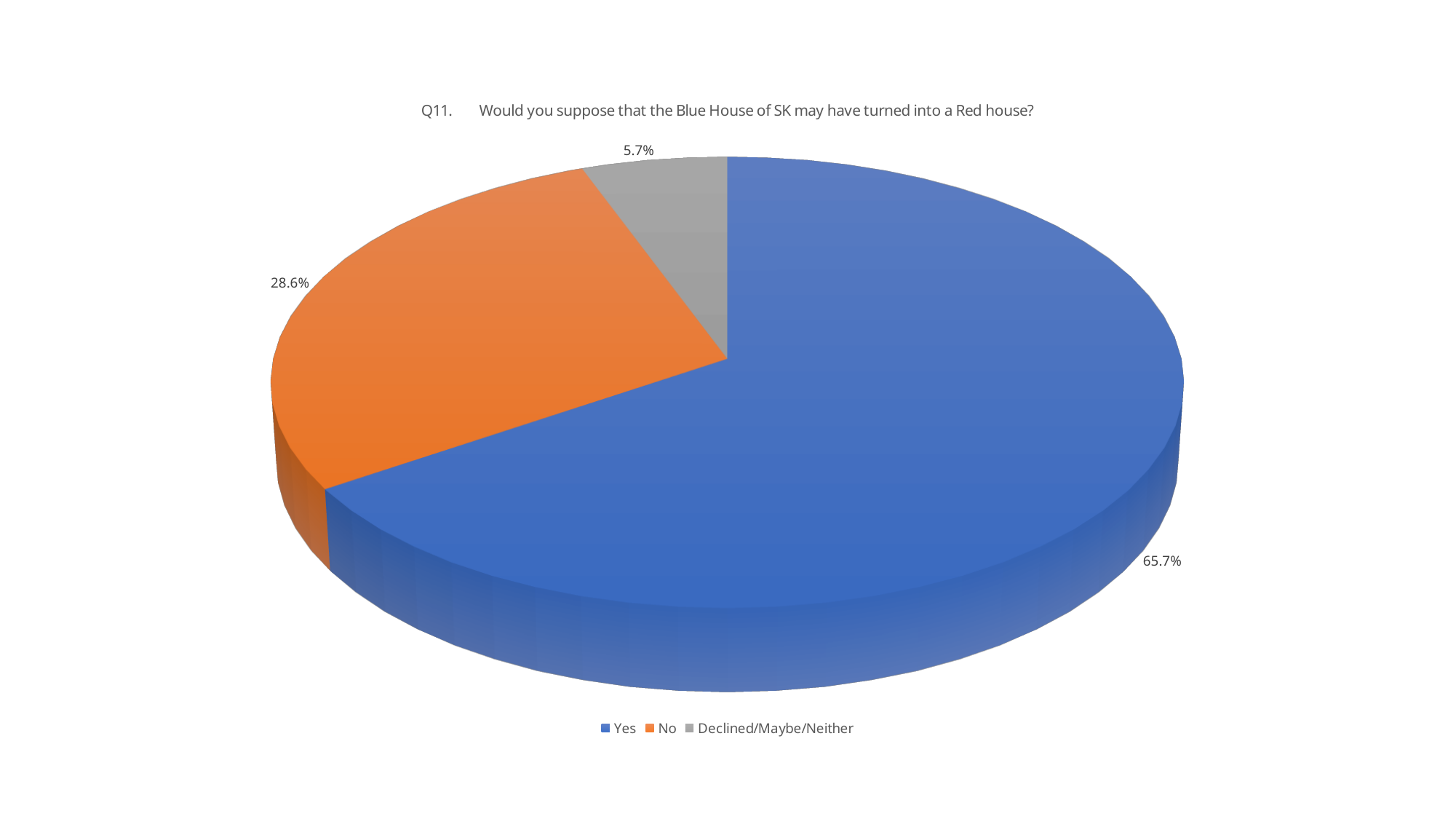
What is the difference in percentage points between No and Declined/Maybe/Neither? 22.9 What percentage is shown for Declined/Maybe/Neither? 5.7% How many entries does the legend list? 3 Which response has the smallest share of the pie? Declined/Maybe/Neither Which response has the largest share of the pie? Yes What percentage of respondents answered Yes? 65.7% What percentage of respondents answered No? 28.6% What is the difference in percentage points between Yes and No? 37.1 What kind of chart is shown on the slide? Pie chart What colour is the slice for No? Orange Which is larger, the share for No or the share for Declined/Maybe/Neither? No How many slices does the pie chart have? 3